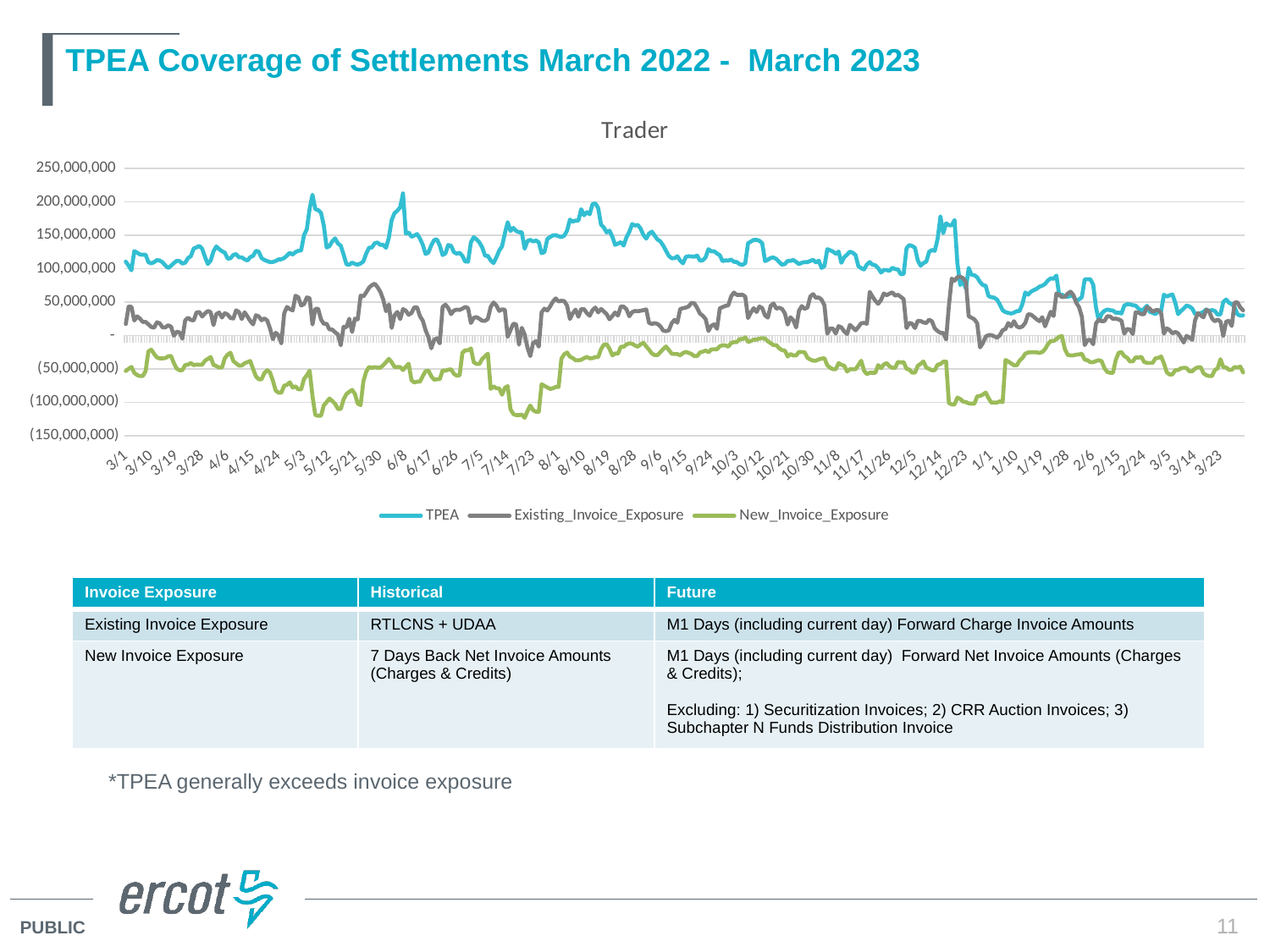
Is the peak value of Existing_Invoice_Exposure around 5/30 greater or less than 50,000,000? greater Does the TPEA series generally rise or fall from March 2022 to March 2023? fall Which series is shown in light blue in the chart? TPEA Which series generally has the lowest values across the chart? New_Invoice_Exposure What is the title of the chart? Trader Is the highest value of TPEA greater or less than 250,000,000? less At 3/1, which is larger: TPEA or New_Invoice_Exposure? TPEA What kind of chart is shown on the slide? line chart Which series generally has the highest values across the chart? TPEA How many series does the chart legend list? 3 Is the peak value of TPEA around 6/8 greater or less than 200,000,000? greater